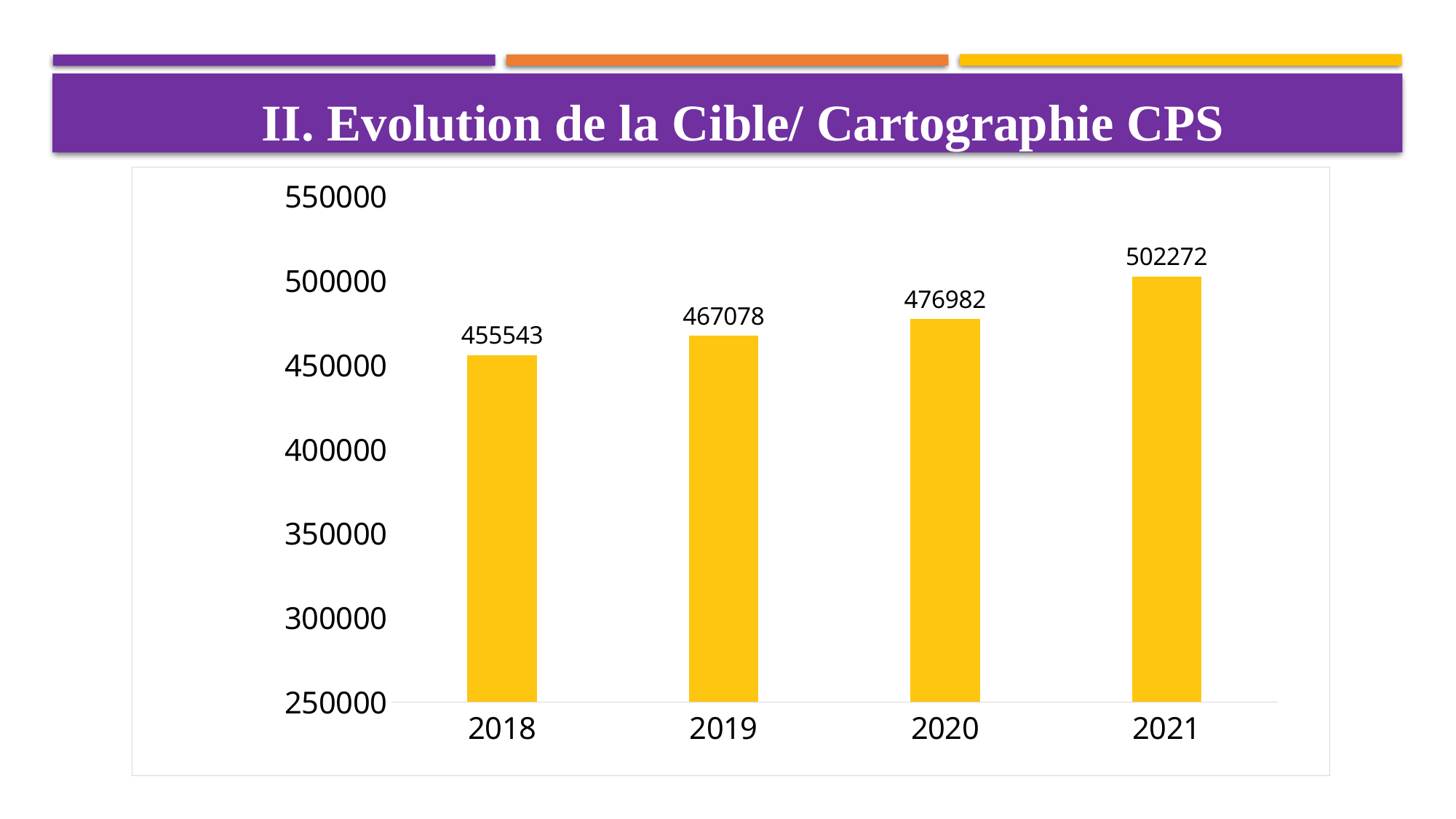
What is the difference between the values for 2021 and 2018? 46729 What is the value for 2021? 502272 How many years are shown on the x axis? 4 What is the difference between the values for 2020 and 2019? 9904 What kind of chart is shown on the slide? bar chart Which year has the highest value? 2021 Which is larger, the value for 2019 or the value for 2020? 2020 What is the value for 2018? 455543 What is the value for 2019? 467078 Which year has the lowest value? 2018 Is the value for 2021 greater or less than 500000? greater What is the value for 2020? 476982